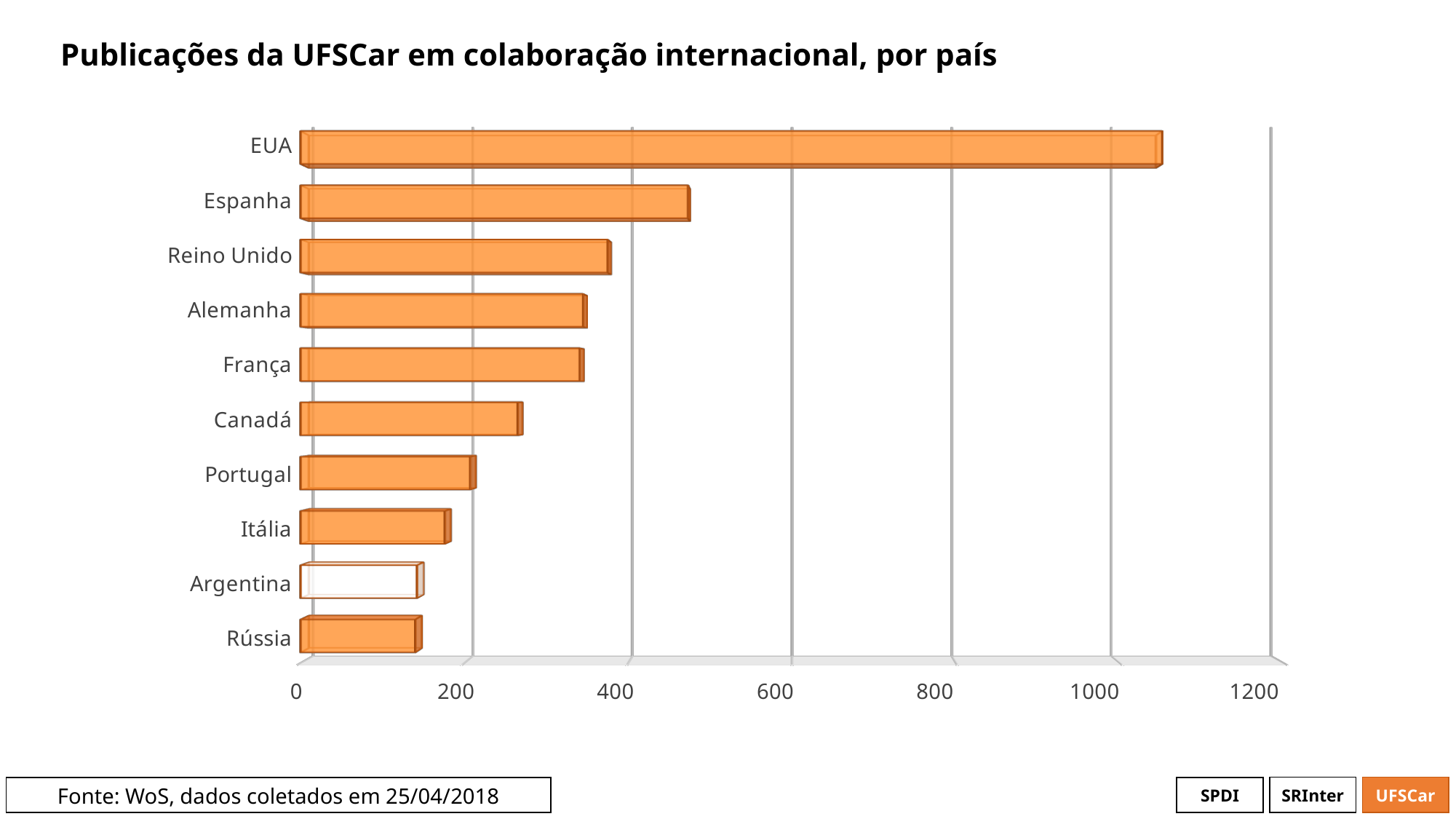
Is the value for Canadá greater or less than 200? greater What is the maximum value shown on the horizontal axis? 1200 Is the value for Reino Unido greater or less than 400? less Is the value for Rússia greater or less than 200? less What is the title of the chart? Publicações da UFSCar em colaboração internacional, por país How many countries are shown in the chart? 10 What kind of chart is shown on the slide? bar chart Which country has the highest number of publications in international collaboration with UFSCar? EUA Which has more publications, Canadá or Portugal? Canadá Which has more publications, Espanha or Reino Unido? Espanha